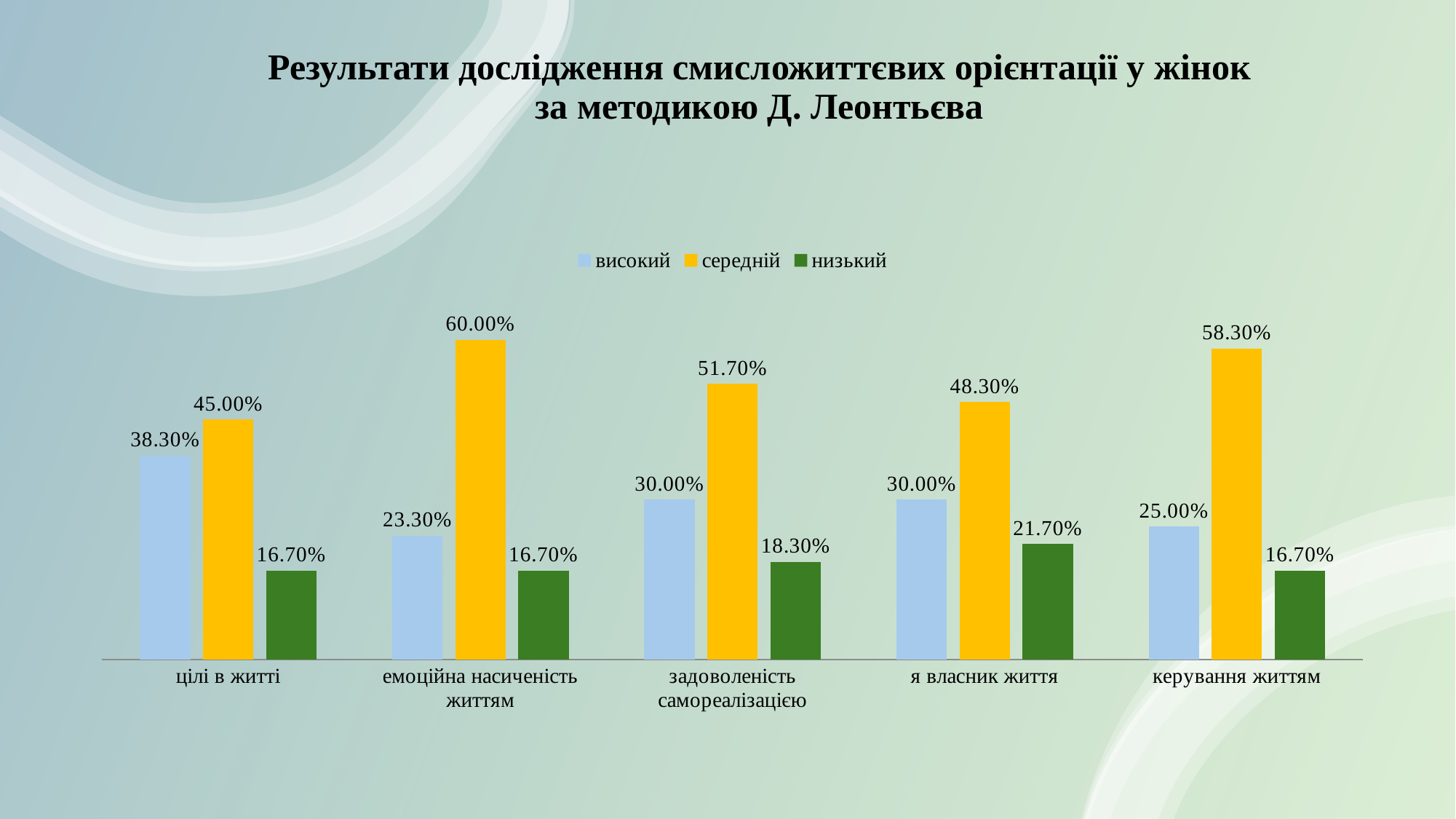
What is the value of the "низький" series for "я власник життя"? 21.70% How many series does the legend list? 3 What is the value of the "середній" series for "емоційна насиченість життям"? 60.00% What is the total of the three series for "задоволеність самореалізацією"? 100.00% Which category has the highest value for the "середній" series? емоційна насиченість життям Which is larger: the "високий" value for "цілі в житті" or the "високий" value for "керування життям"? цілі в житті Which colour represents the "низький" series in the legend? green What is the value of the "високий" series for "цілі в житті"? 38.30% Which category has the lowest value for the "високий" series? емоційна насиченість життям What kind of chart is shown on the slide? bar chart How many categories are shown on the x axis? 5 What is the difference between the "середній" and "високий" values for "керування життям"? 33.30%